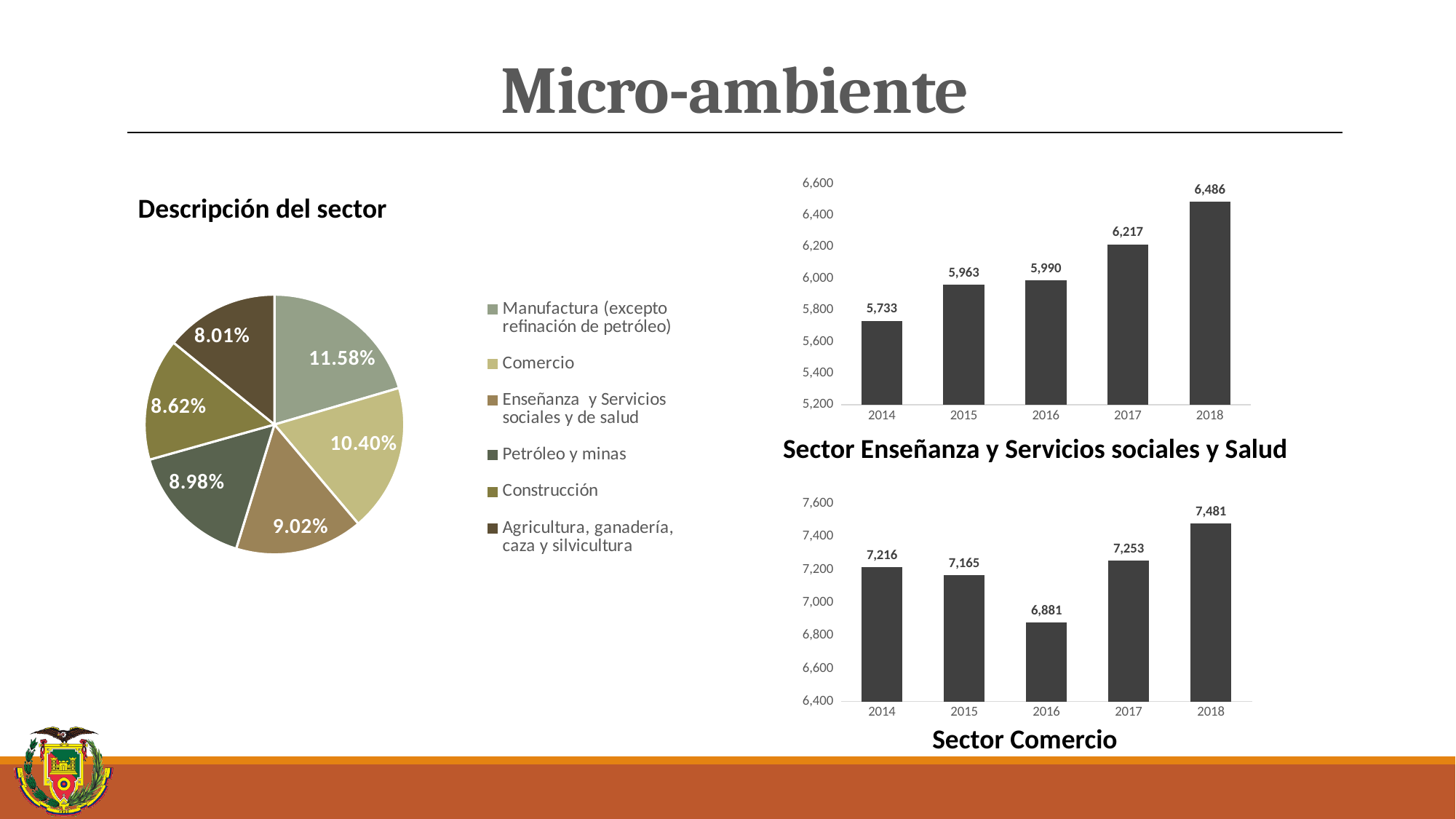
In the 'Sector Enseñanza y Servicios sociales y Salud' chart, which year has the highest value? 2018 In the 'Sector Comercio' chart, which year has the lowest value? 2016 In the 'Sector Comercio' chart, which is larger, the value for 2015 or the value for 2017? 2017 How many years are shown in the 'Sector Comercio' chart? 5 What type of chart is 'Descripción del sector'? pie chart In the 'Descripción del sector' pie chart, what share does Comercio have? 10.40% In the 'Sector Enseñanza y Servicios sociales y Salud' chart, what is the difference between the 2018 and 2014 values? 753 In the 'Sector Comercio' chart, what is the difference between the 2018 and 2016 values? 600 In the 'Sector Enseñanza y Servicios sociales y Salud' chart, do the values rise or fall from 2014 to 2018? rise In the 'Sector Enseñanza y Servicios sociales y Salud' chart, what is the value for 2016? 5,990 In the 'Descripción del sector' pie chart, which sector has the largest slice? Manufactura (excepto refinación de petróleo) In the 'Sector Comercio' chart, what is the value for 2014? 7,216